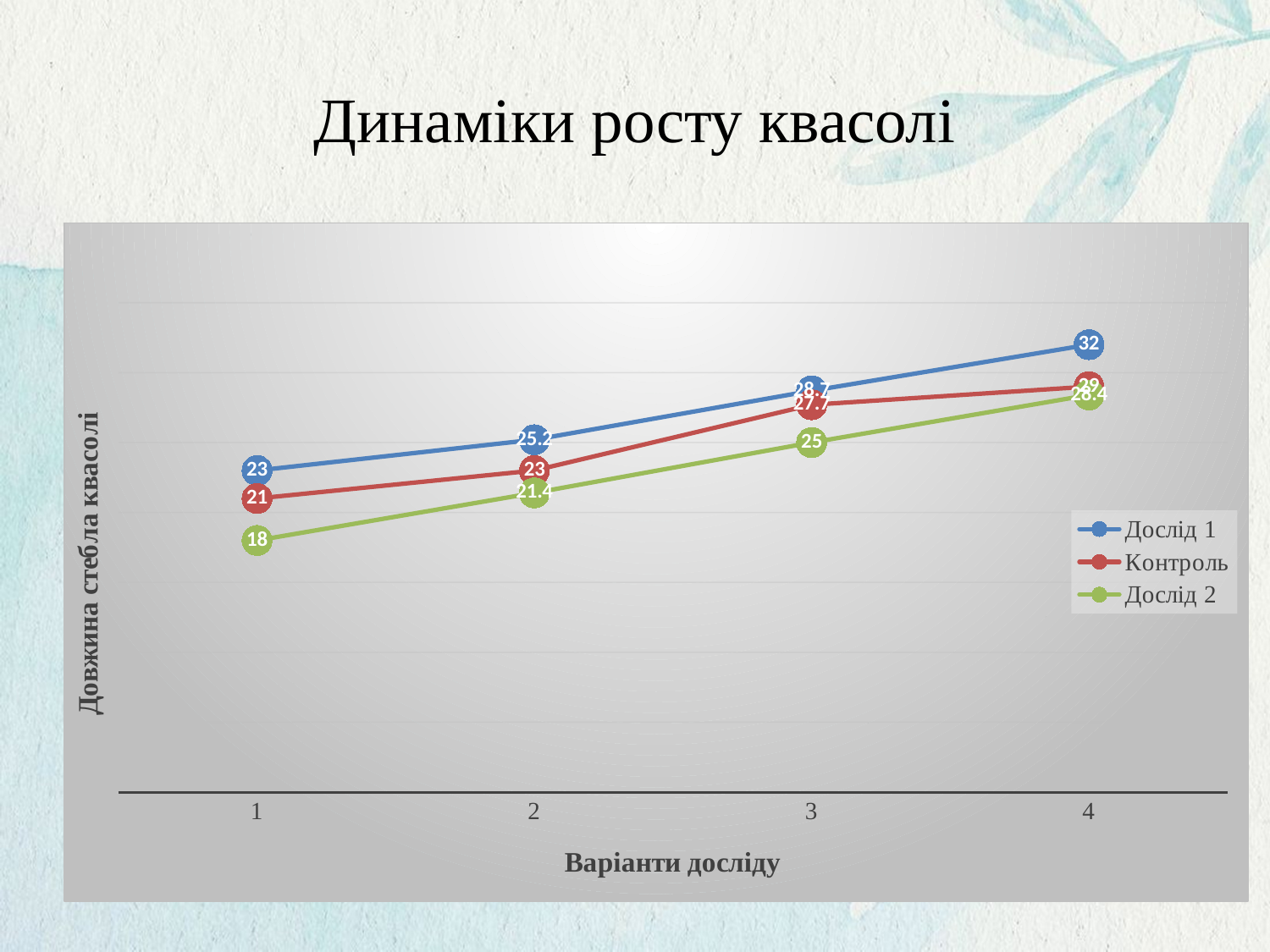
What is the value of Дослід 1 at x = 4? 32 What is the difference between Дослід 1 and Дослід 2 at x = 1? 5 What is the value of Дослід 1 at x = 2? 25.2 How many series does the legend list? 3 What type of chart is shown on the slide? line chart Do the values of Контроль rise or fall from x = 1 to x = 4? rise What is the title of the x axis? Варіанти досліду What is the value of Контроль at x = 3? 27.7 Which is larger at x = 2: Контроль or Дослід 2? Контроль At which x-axis category does Дослід 2 reach its highest value? 4 Which series has the lowest value at x = 1? Дослід 2 What is the value of Дослід 2 at x = 1? 18